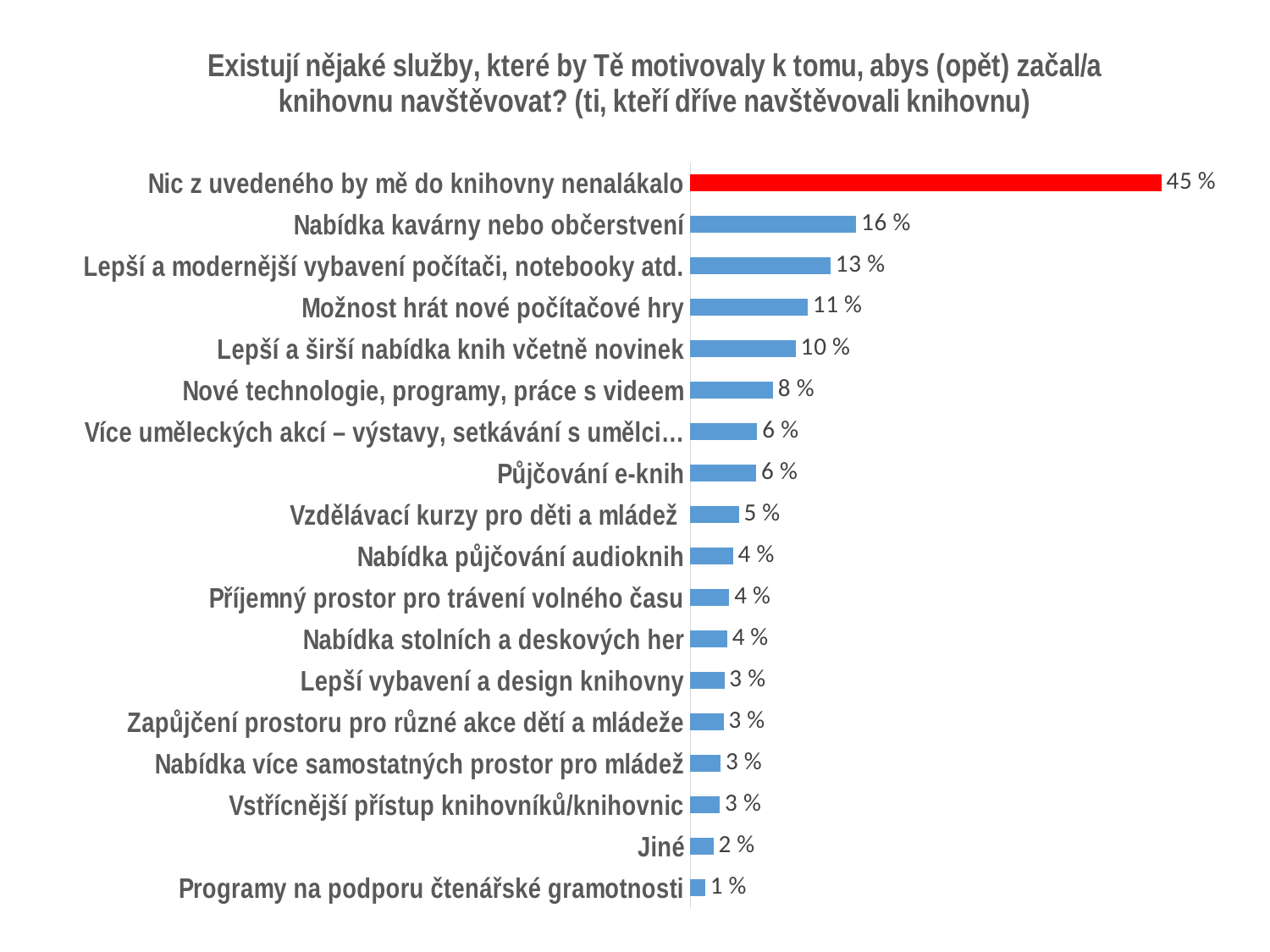
Which category has the lowest value? Programy na podporu čtenářské gramotnosti Which bar is coloured red instead of blue? Nic z uvedeného by mě do knihovny nenalákalo What is the value for "Nic z uvedeného by mě do knihovny nenalákalo"? 45 % What is the difference between the values for "Možnost hrát nové počítačové hry" and "Nové technologie, programy, práce s videem"? 3 % Which is larger: the value for "Lepší a modernější vybavení počítači, notebooky atd." or the value for "Lepší a širší nabídka knih včetně novinek"? Lepší a modernější vybavení počítači, notebooky atd. What is the value for "Nabídka kavárny nebo občerstvení"? 16 % How many categories are shown in the chart? 18 What is the difference between the values for "Nic z uvedeného by mě do knihovny nenalákalo" and "Nabídka kavárny nebo občerstvení"? 29 % What is the value for "Půjčování e-knih"? 6 % What is the value for "Jiné"? 2 % What kind of chart is shown on the slide? Bar chart Which category has the highest value? Nic z uvedeného by mě do knihovny nenalákalo